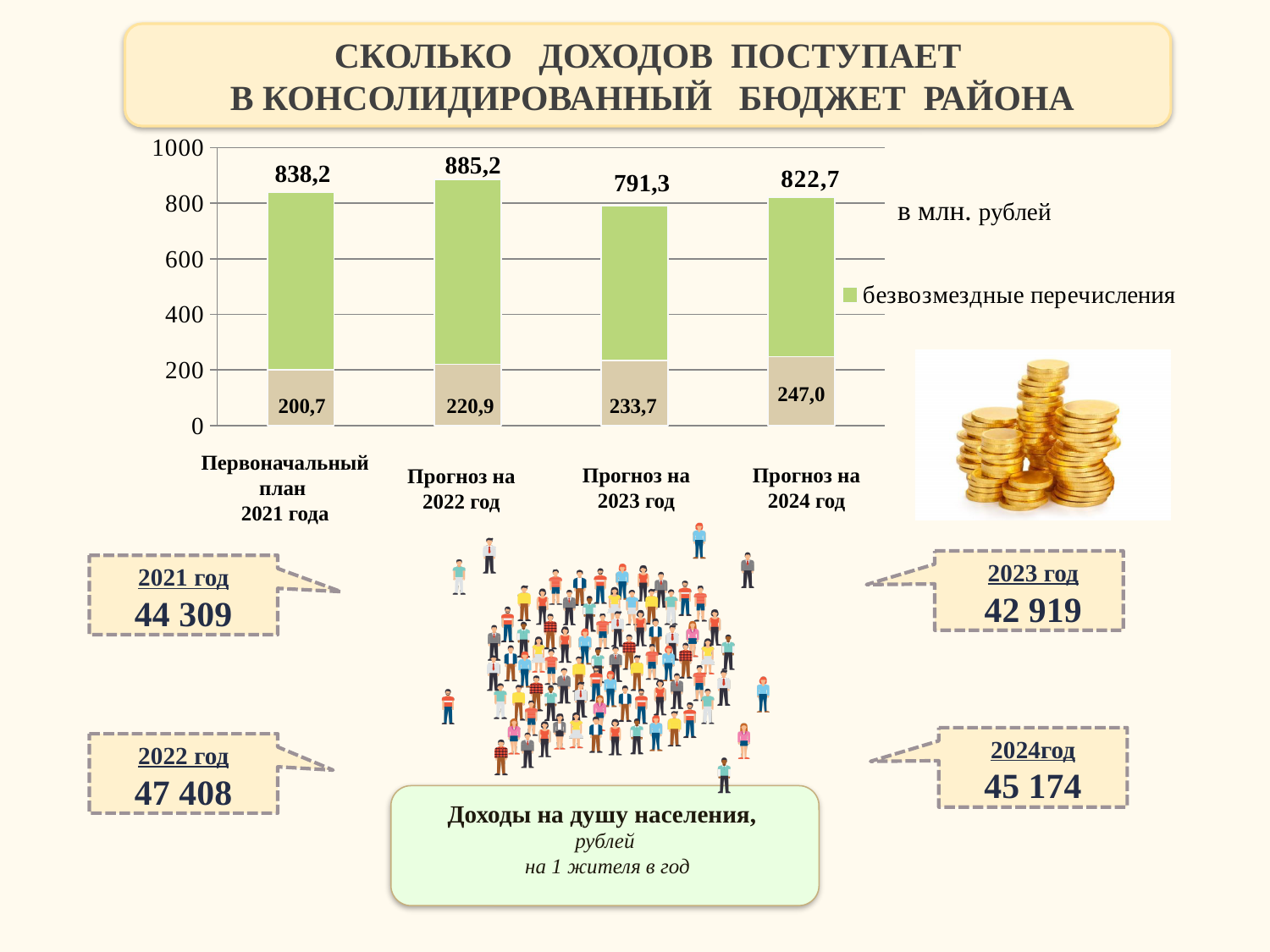
How many bars are shown in the chart? 4 Which bar is taller: 'Первоначальный план 2021 года' or 'Прогноз на 2024 год'? Первоначальный план 2021 года What value is printed on the lower (beige) segment of the bar for 'Прогноз на 2024 год'? 247,0 Do the values printed on the lower (beige) segments rise or fall from 2021 to 2024? Rise What unit is stated next to the chart? в млн. рублей Which category has the tallest bar? Прогноз на 2022 год What value is printed on the lower (beige) segment of the bar for 'Первоначальный план 2021 года'? 200,7 Which category has the shortest bar? Прогноз на 2023 год What kind of chart is shown on the slide? Bar chart What is the entry shown in the chart legend? безвозмездные перечисления What value is labeled at the top of the bar for 'Прогноз на 2022 год'? 885,2 What is the difference between the top labels of the bars for 'Прогноз на 2022 год' (885,2) and 'Прогноз на 2023 год' (791,3)? 93,9